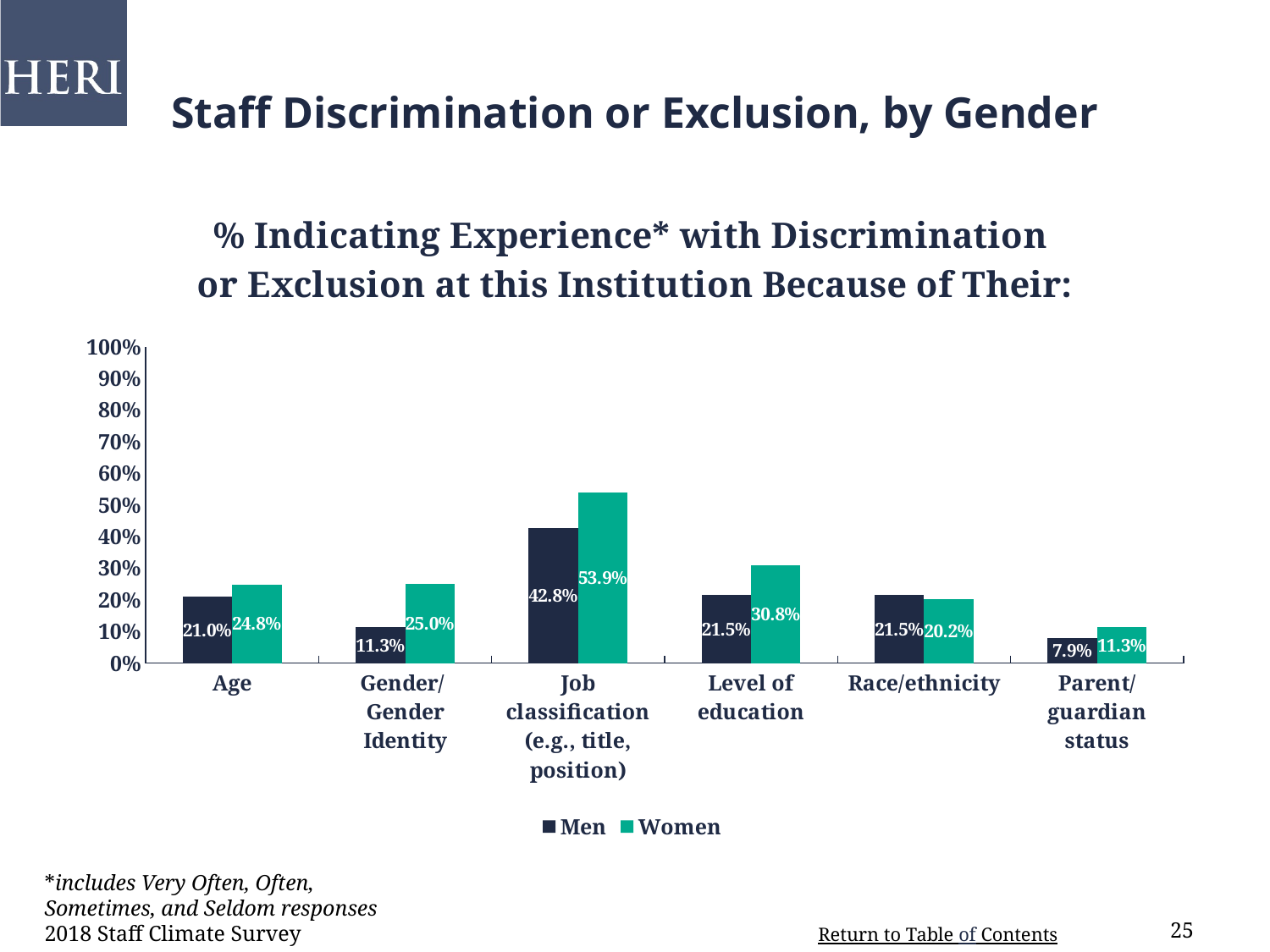
For Race/ethnicity, which group has the larger value, men or women? Men How many series does the legend list? 2 Which category has the lowest value for men? Parent/guardian status Is the value for women for Job classification greater or less than 50%? greater What percentage of men indicated experience with discrimination or exclusion because of their age? 21.0% How many categories are shown on the x axis? 6 What percentage of women indicated experience with discrimination or exclusion because of their job classification? 53.9% What kind of chart is shown on the slide? Bar chart Which category has the highest value for women? Job classification (e.g., title, position) What is the difference between the women's and men's values for Level of education? 9.3% What is the difference between the women's and men's values for Gender/Gender Identity? 13.7% What is the value for men for Parent/guardian status? 7.9%